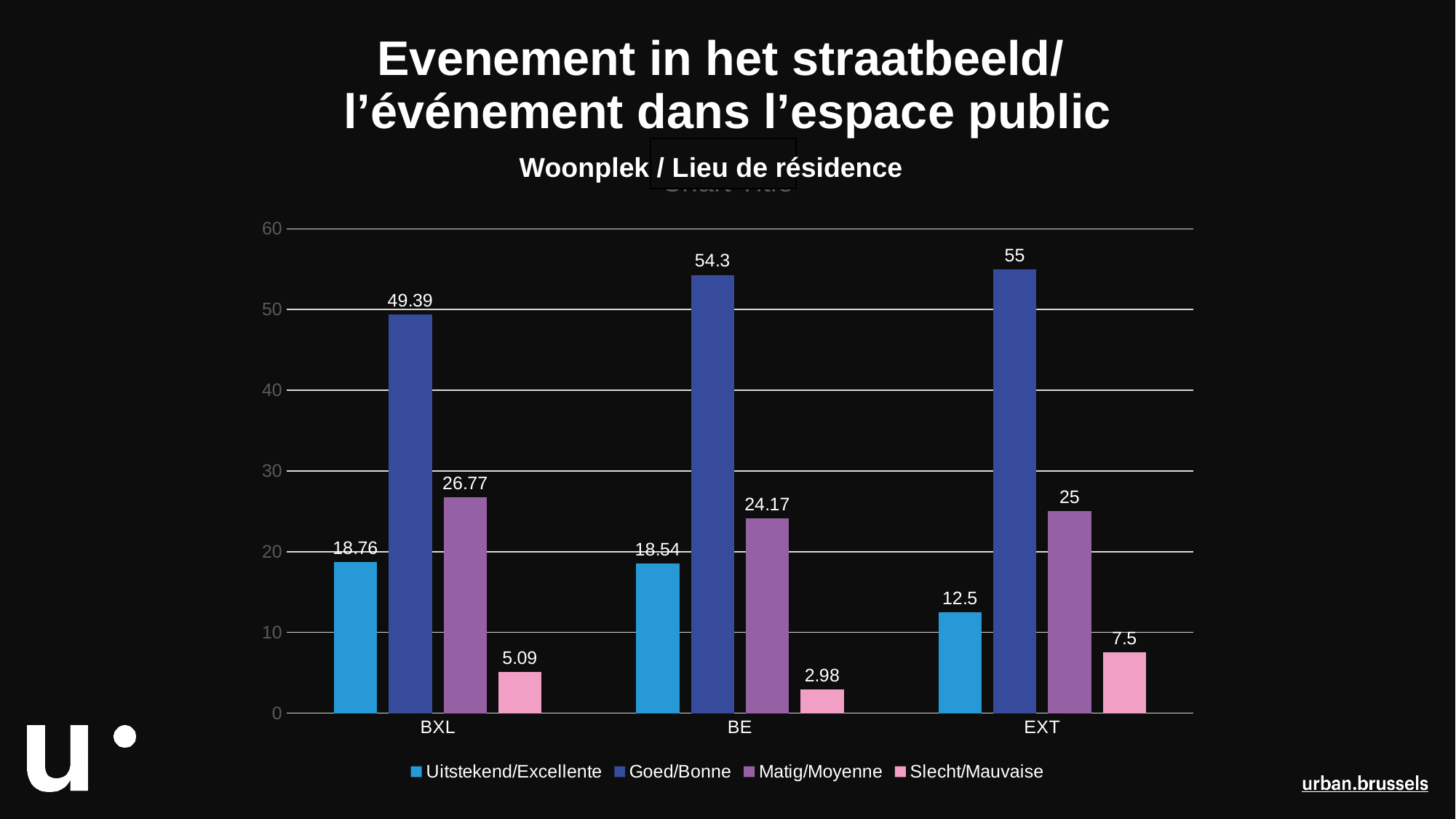
What is the value for Uitstekend/Excellente in the EXT category? 12.5 What is the subtitle shown above the chart? Woonplek / Lieu de résidence How many series does the legend list? 4 What is the value for Matig/Moyenne in the BE category? 24.17 What is the value for Slecht/Mauvaise in the BXL category? 5.09 What kind of chart is shown on the slide? Bar chart Which category has the highest value for Goed/Bonne? EXT Which is larger: Matig/Moyenne for BXL or Matig/Moyenne for EXT? BXL Which category has the lowest value for Slecht/Mauvaise? BE What is the difference between the Goed/Bonne values for EXT and BXL? 5.61 What is the value for Goed/Bonne in the BE category? 54.3 How many categories are shown on the x axis? 3